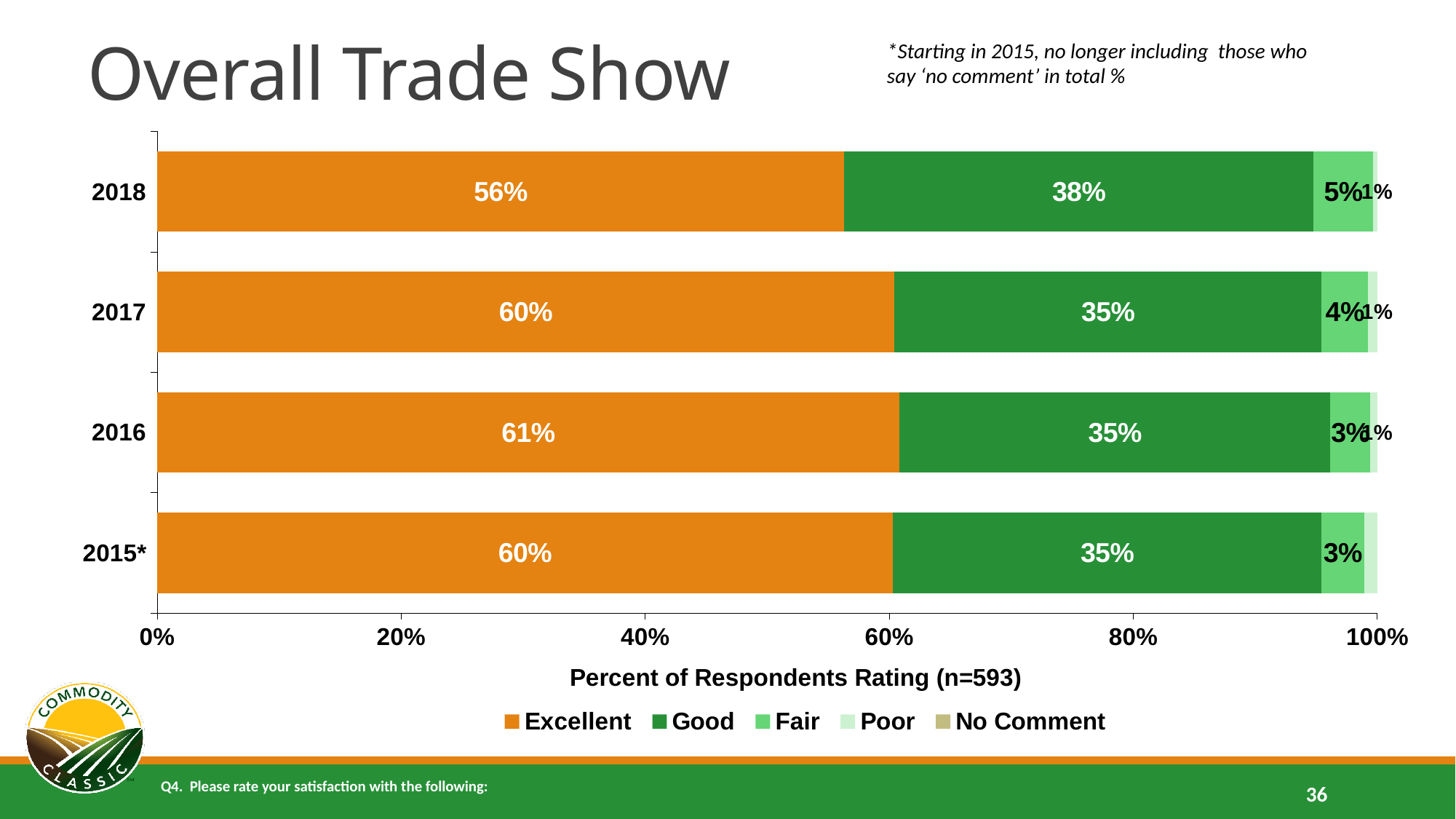
Which year has the lowest Excellent rating? 2018 How many years are shown on the chart? 4 What is the Excellent rating for 2016? 61% How many series does the legend list? 5 What percentage of respondents rated the Overall Trade Show as Good in 2018? 38% What is the difference between the Excellent rating in 2016 and in 2018? 5 percentage points What percentage of respondents rated the Overall Trade Show as Excellent in 2018? 56% What is the Fair rating for 2017? 4% What kind of chart is shown on the slide? Stacked bar chart Is the Good rating larger in 2018 or in 2017? 2018 Which year has the highest Excellent rating? 2016 What is the x-axis title of the chart? Percent of Respondents Rating (n=593)